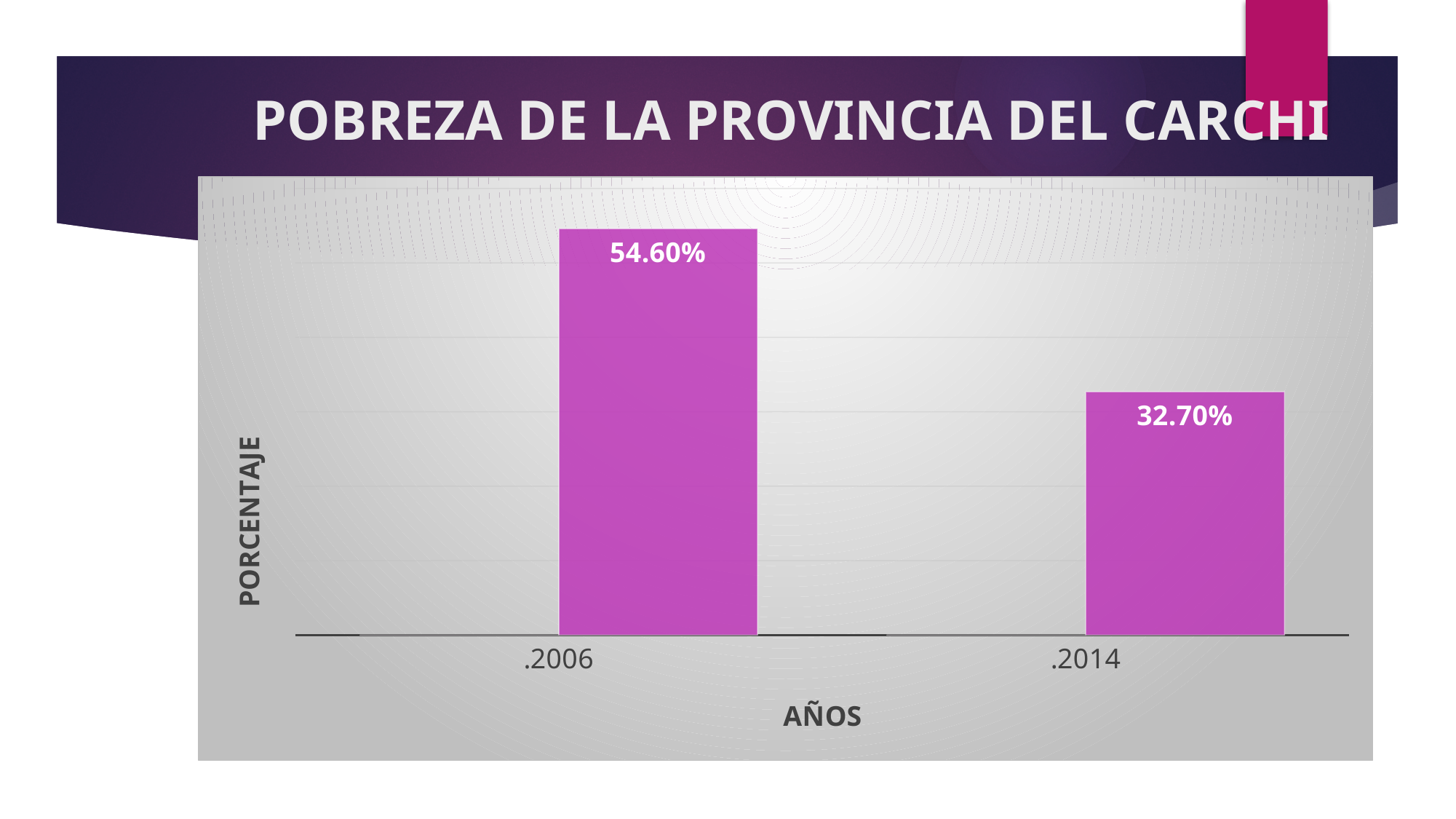
How many years (categories) are plotted on the chart? 2 What is the poverty percentage shown for 2014? 32.70% What kind of chart is shown on the slide? bar chart What is the label on the x axis of the chart? AÑOS By how many percentage points did the poverty rate fall from 2006 to 2014? 21.90% Does the poverty percentage rise or fall from 2006 to 2014? fall What is the title of the slide's chart? POBREZA DE LA PROVINCIA DEL CARCHI What is the poverty percentage shown for 2006? 54.60% Is the value for 2006 larger or smaller than the value for 2014? larger Which year has the lower poverty percentage? 2014 Which year has the higher poverty percentage? 2006